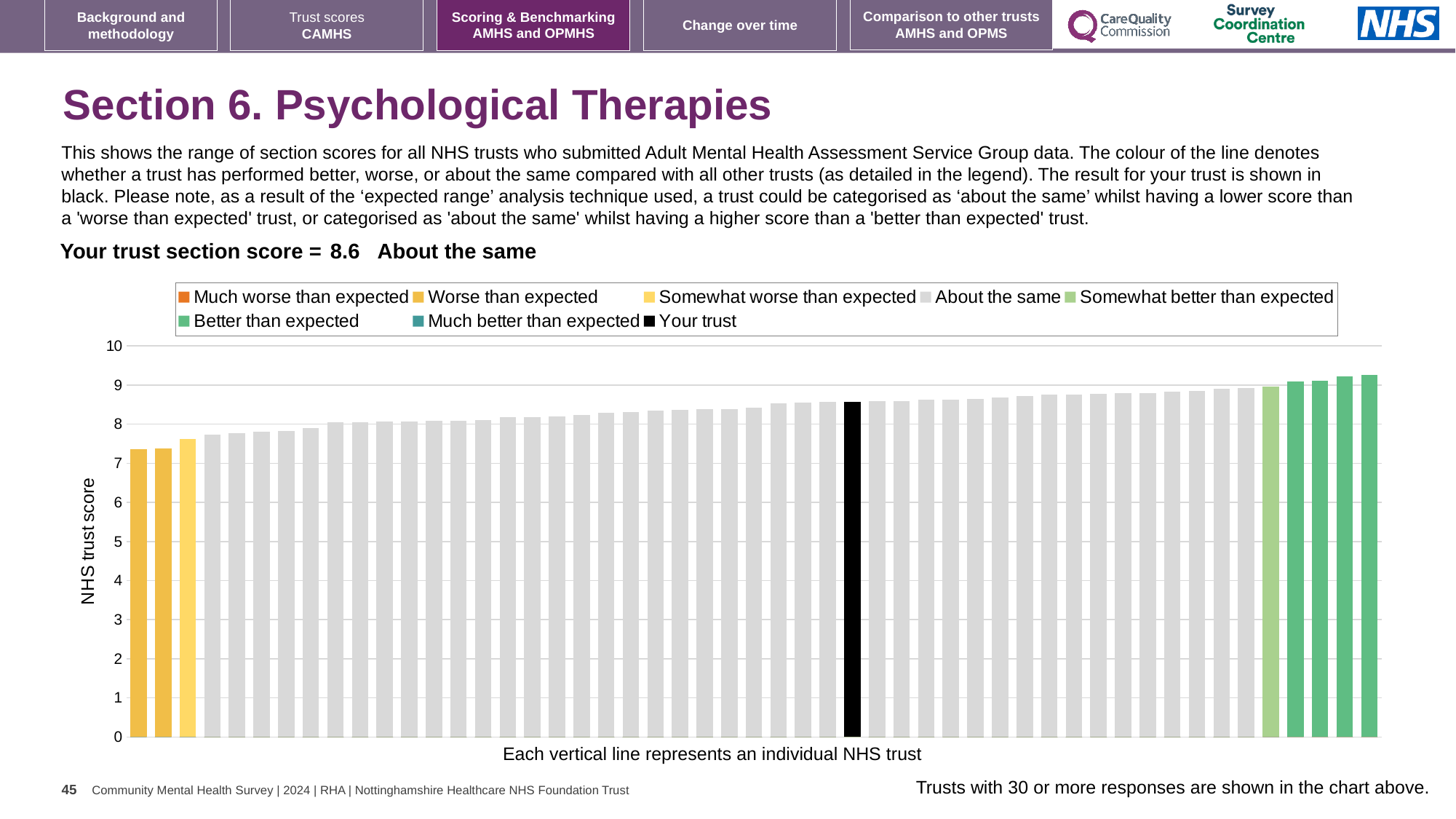
Is the value of the lowest bar in the chart greater or less than 8? less Do the bar values rise or fall from left to right along the x axis? rise Is the value for Your trust greater or less than 9? less Is the value for Your trust greater or less than 8? greater What kind of chart is shown on the slide? bar chart How many bars are coloured as 'Better than expected'? 4 What is the section score for Your trust shown on the slide? 8.6 How many entries does the chart legend list? 8 How many bars are coloured as 'Worse than expected'? 2 What is the label on the y axis of the chart? NHS trust score What colour is the bar for Your trust in the chart? black